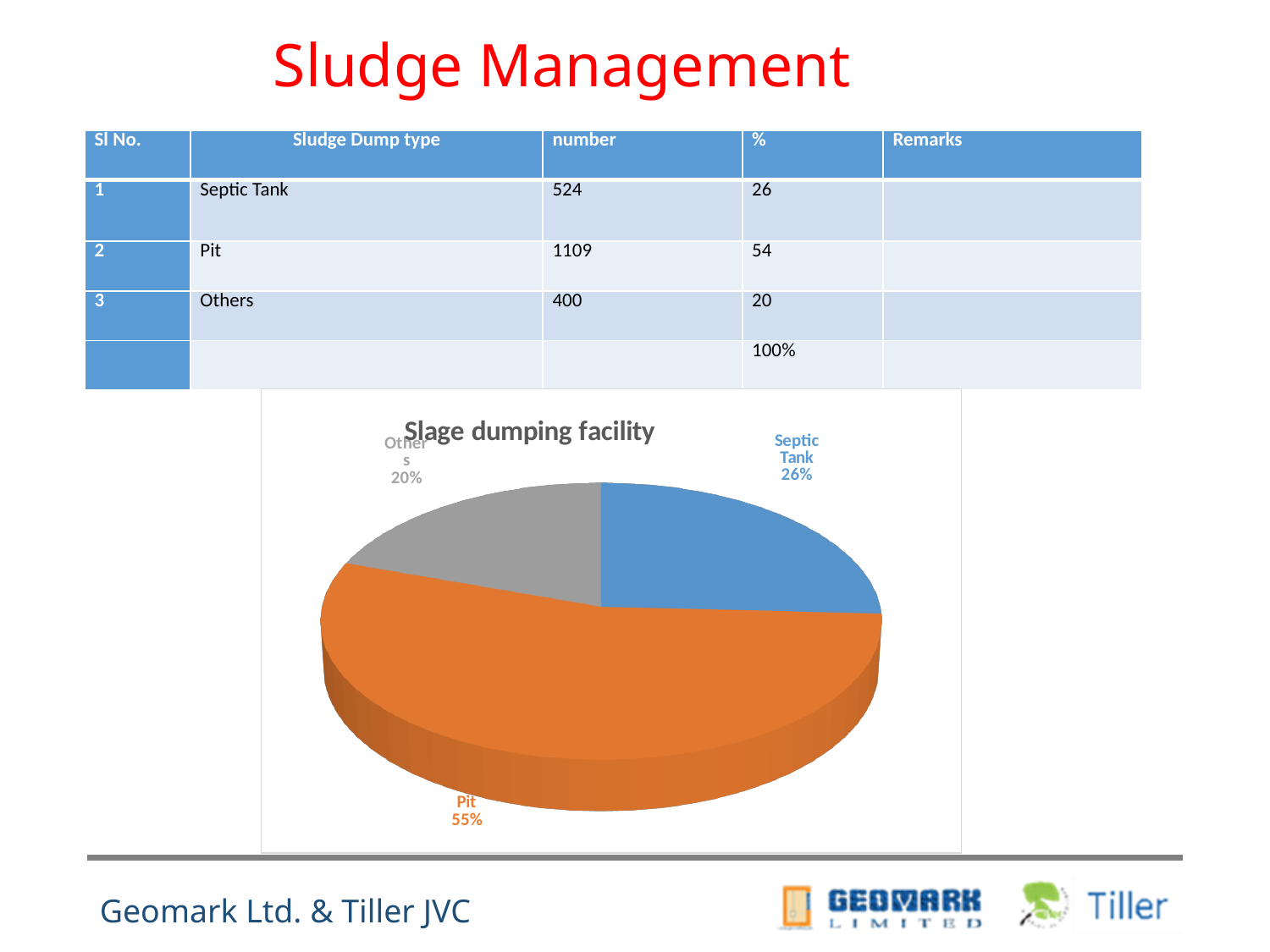
How many slices does the pie chart have? 3 What share of the pie chart does Septic Tank account for? 26% What is the title of the pie chart? Slage dumping facility What share of the pie chart does Others account for? 20% In the pie chart, what is the difference in percentage points between Pit and Septic Tank? 29 Which slice of the pie chart is the largest? Pit What share of the pie chart does Pit account for? 55% What kind of chart is shown on the slide? Pie chart What colour is the Pit slice in the pie chart? Orange In the pie chart, which is larger, Septic Tank or Others? Septic Tank In the pie chart, what is the difference in percentage points between Septic Tank and Others? 6 Which slice of the pie chart is the smallest? Others